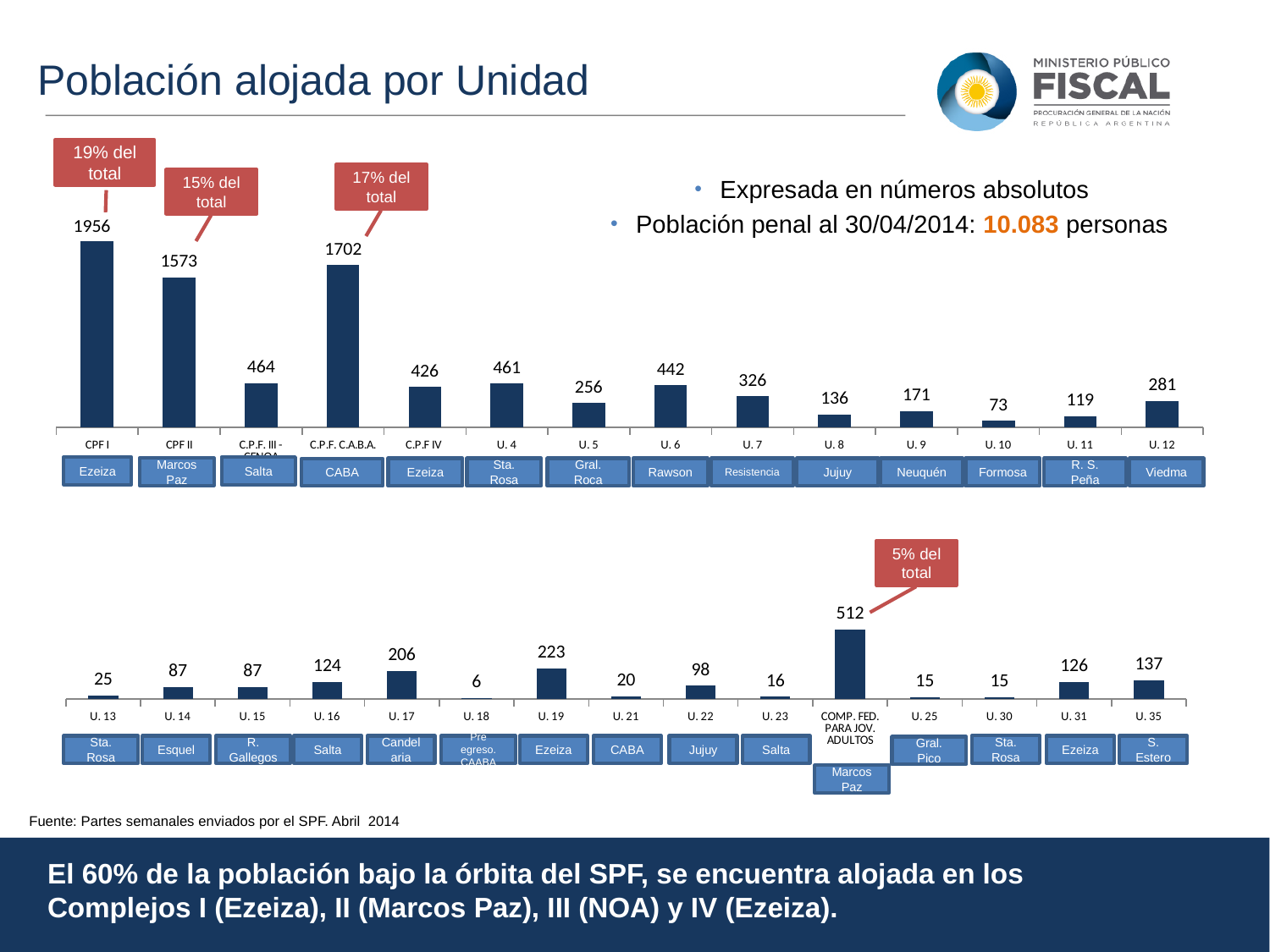
How many units are shown in the top chart? 14 How many categories are shown in the bottom chart? 15 In the top chart, what is the difference between CPF I and CPF II? 383 In the top chart, which is larger, U. 4 or U. 5? U. 4 In the top chart, what is the value for CPF I? 1956 In the bottom chart, which category has the highest value? COMP. FED. PARA JOV. ADULTOS In the top chart, which unit has the lowest value? U. 10 In the bottom chart, what is the difference between U. 35 and U. 31? 11 In the bottom chart, what is the value for U. 19? 223 What type of chart is used on this slide? Bar chart In the top chart, what is the value for U. 6? 442 In the bottom chart, which unit has the lowest value? U. 18